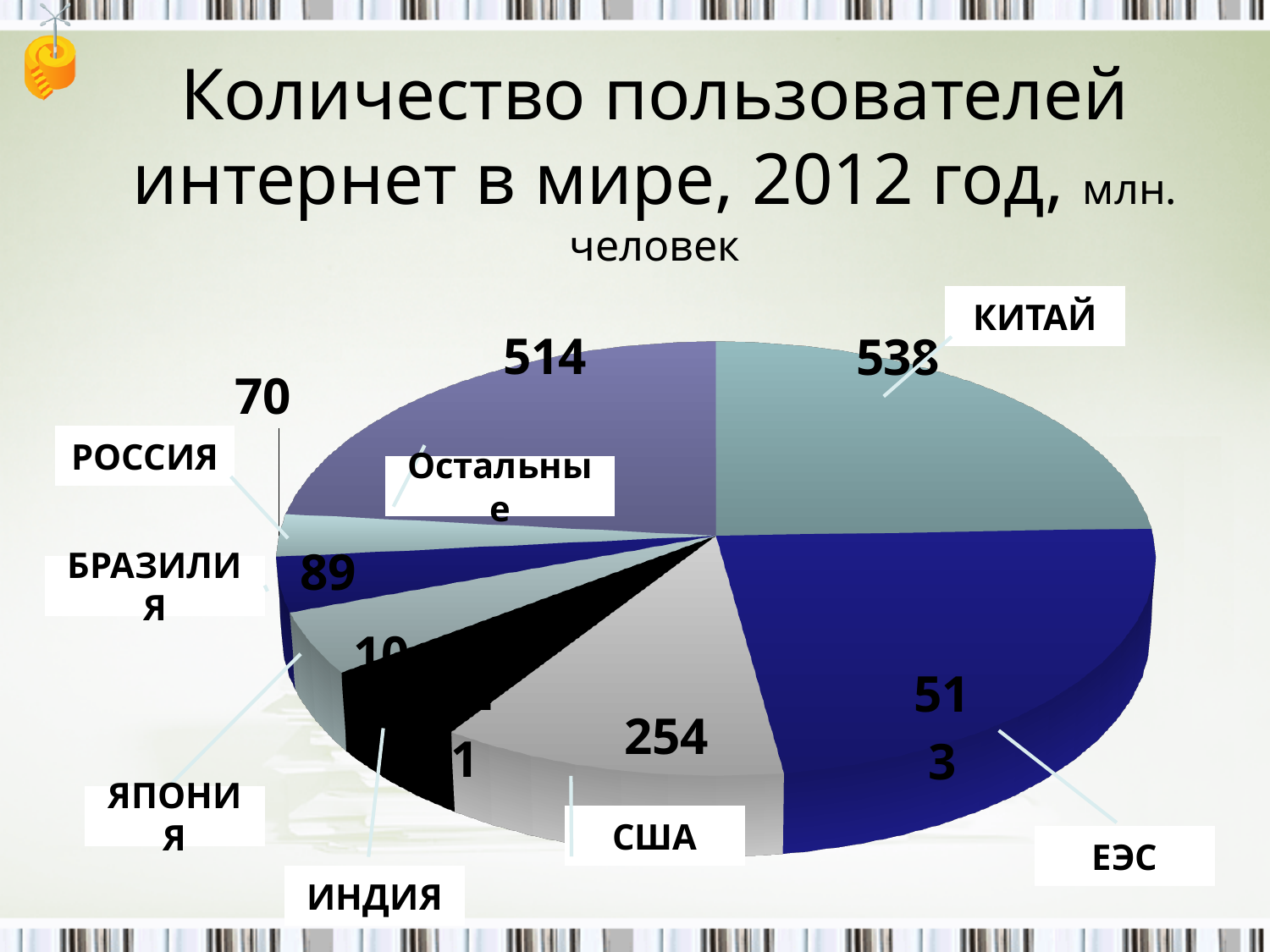
What is the value for РОССИЯ? 70 What is the value for США? 254 How many slices does the pie chart have? 8 Which category has the lowest value? РОССИЯ What is the value for БРАЗИЛИЯ? 89 What is the value for КИТАЙ? 538 What is the value for Остальные? 514 What kind of chart is shown on the slide? pie chart What is the difference between the values for КИТАЙ and ЕЭС? 25 Which is larger, the value for США or the value for БРАЗИЛИЯ? США Which category has the highest value? КИТАЙ What is the value for ЕЭС? 513